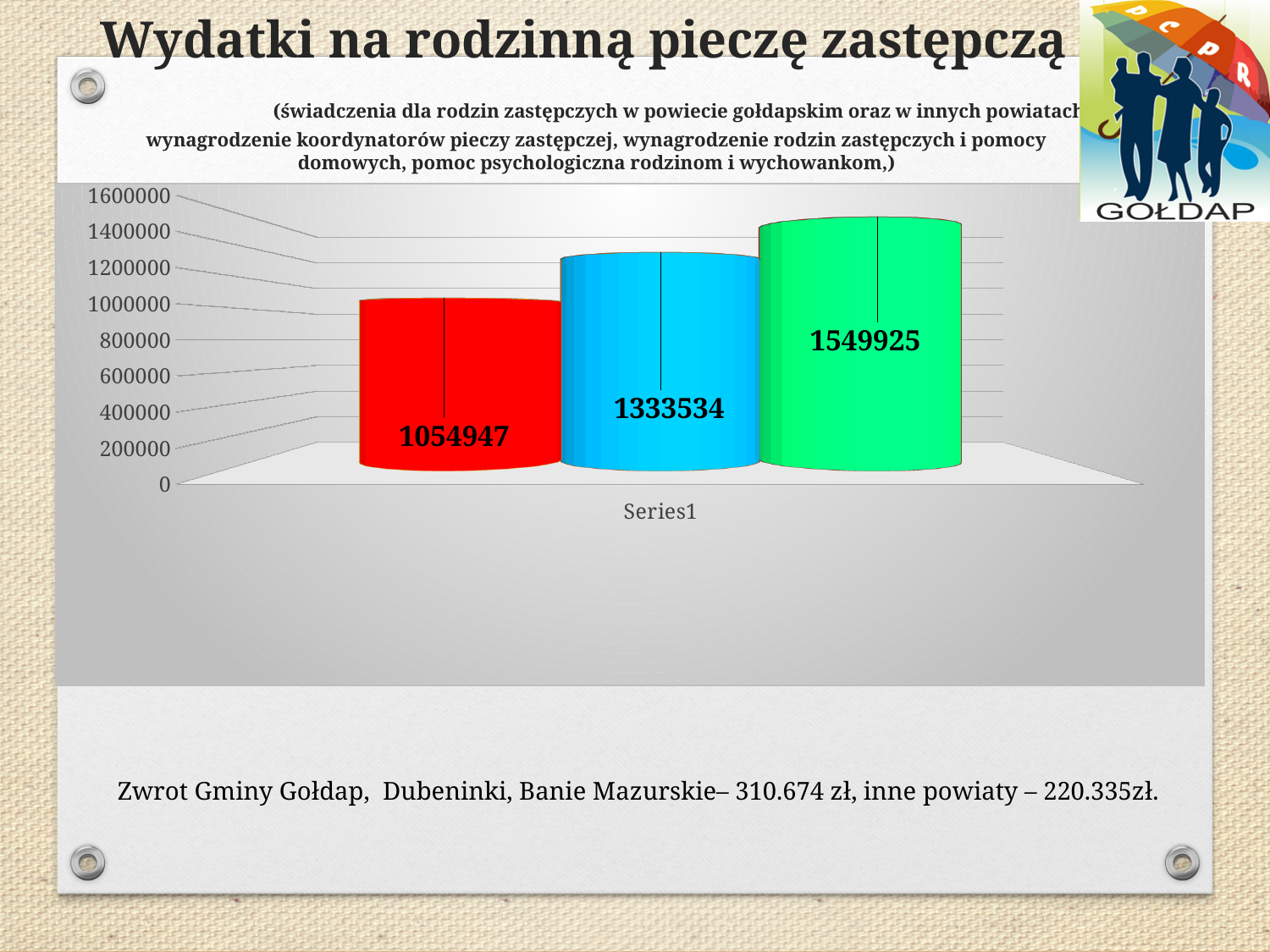
Is the value of the red bar greater or less than 1000000? greater Do the bar values rise or fall from left to right? rise Which bar has the lowest value? the red bar What value is shown on the green bar? 1549925 Which is larger, the blue bar or the green bar? the green bar Which bar has the highest value? the green bar What kind of chart is shown on the slide? bar chart What is the difference between the blue bar and the red bar? 278587 How many bars are plotted in the chart? 3 What value is shown on the red bar? 1054947 What value is shown on the blue bar? 1333534 What is the difference between the green bar and the red bar? 494978